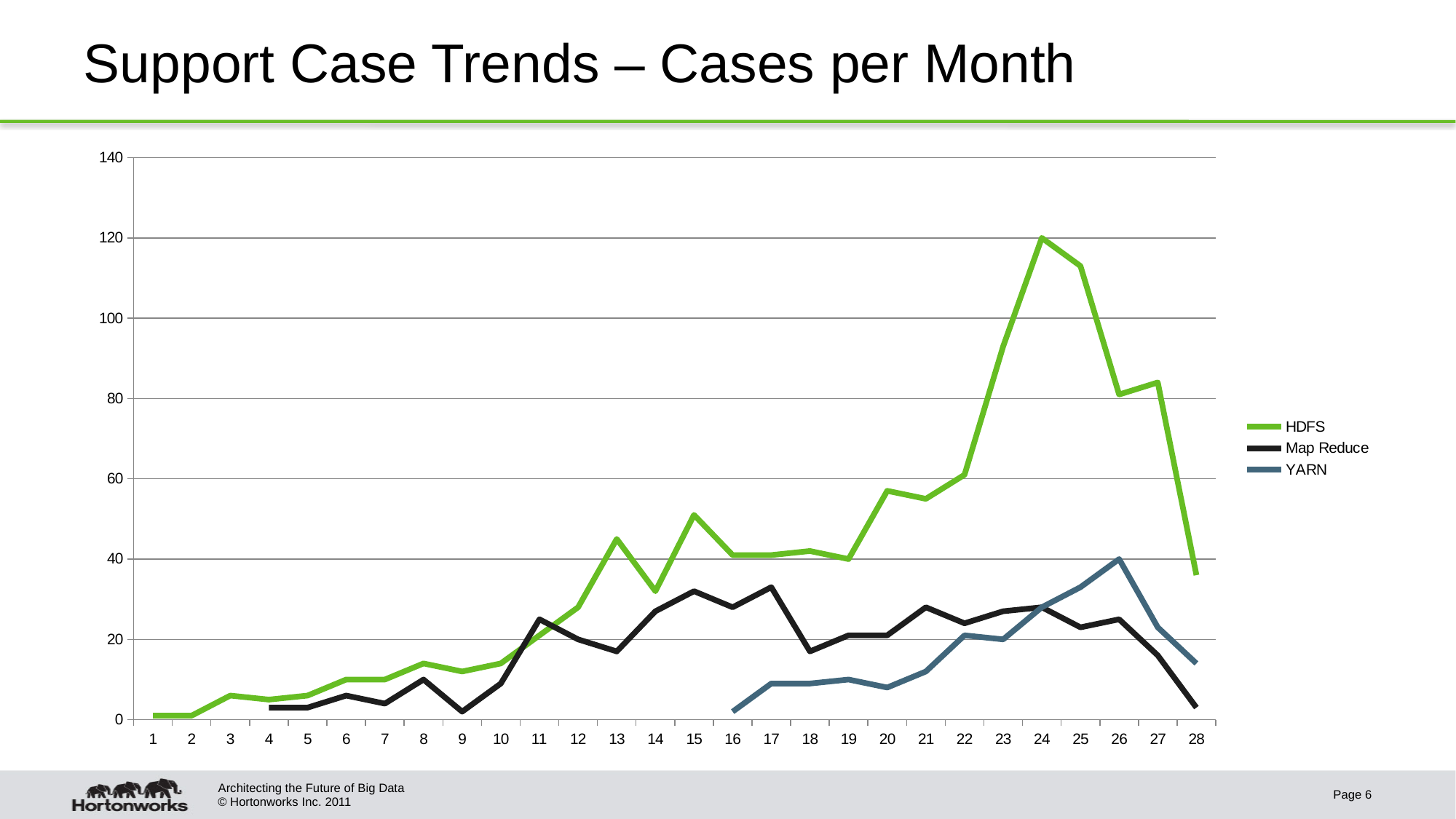
How many series does the legend list? 3 How many months are plotted along the x axis? 28 In which month does the HDFS series reach its highest value? 24 Is the HDFS value in month 25 greater or less than 100? greater Is the Map Reduce value in month 17 greater or less than 20? greater What kind of chart is shown on the slide? line chart What is the YARN value in month 26? 40 Is the YARN value in month 16 greater or less than 20? less Does the HDFS series rise or fall from month 24 to month 28? fall In month 26, which series has the higher value, YARN or Map Reduce? YARN What is the title of the chart slide? Support Case Trends – Cases per Month What is the HDFS value in month 24? 120